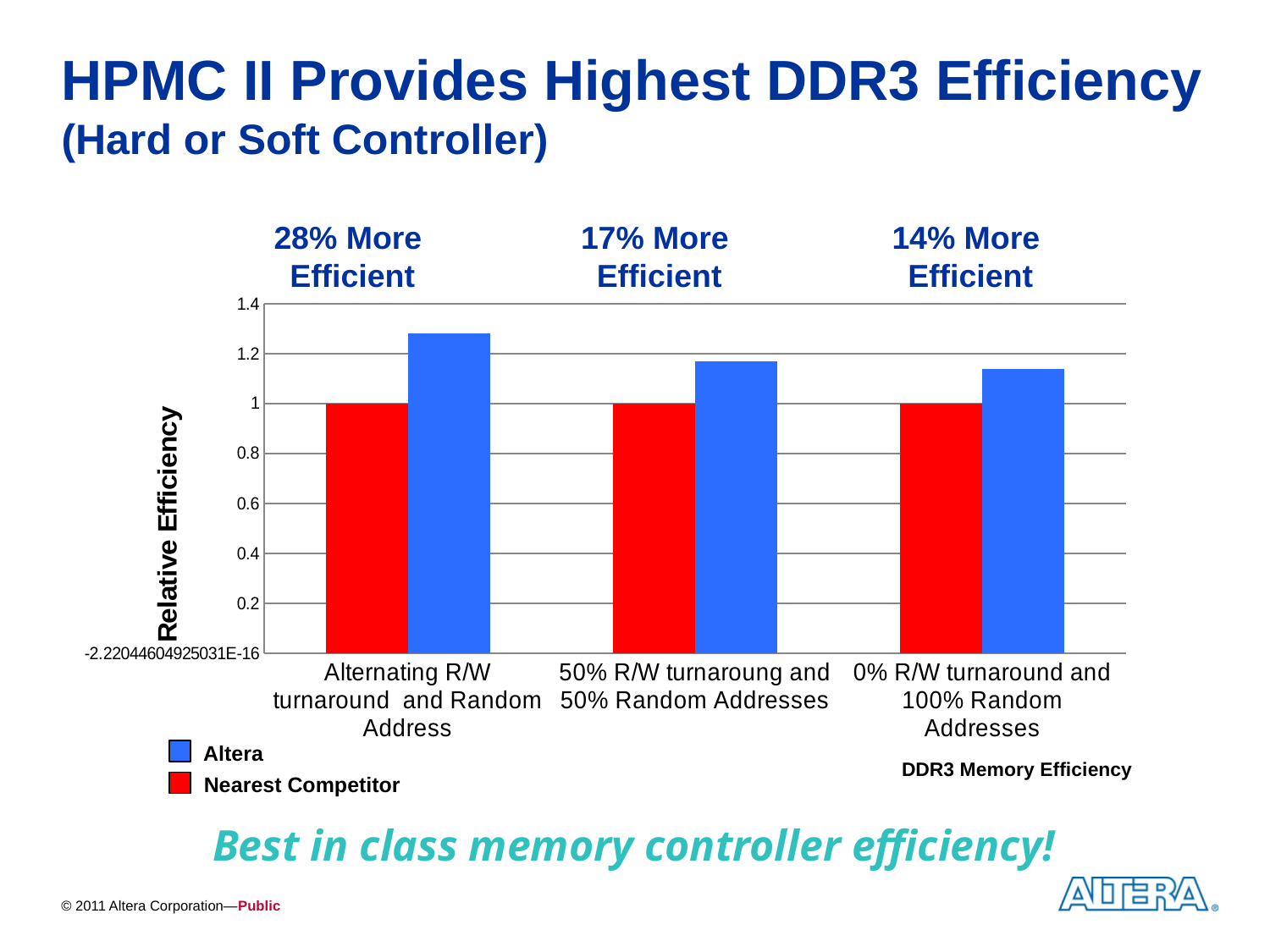
How many series does the legend list? 2 Is the Altera value for '0% R/W turnaround and 100% Random Addresses' greater or less than 1.2? less What is the relative efficiency of the Nearest Competitor for '0% R/W turnaround and 100% Random Addresses'? 1 How many categories are shown on the x axis? 3 What kind of chart is shown on the slide? bar chart Do the Altera values rise or fall from left to right along the x axis? fall Which category has the lowest Altera bar? 0% R/W turnaround and 100% Random Addresses For '50% R/W turnaroung and 50% Random Addresses', which is larger: Altera or Nearest Competitor? Altera Is the Altera value for 'Alternating R/W turnaround and Random Address' greater or less than 1.2? greater What is the relative efficiency of the Nearest Competitor for 'Alternating R/W turnaround and Random Address'? 1 Which category has the highest Altera bar? Alternating R/W turnaround and Random Address What is the title of the y axis? Relative Efficiency